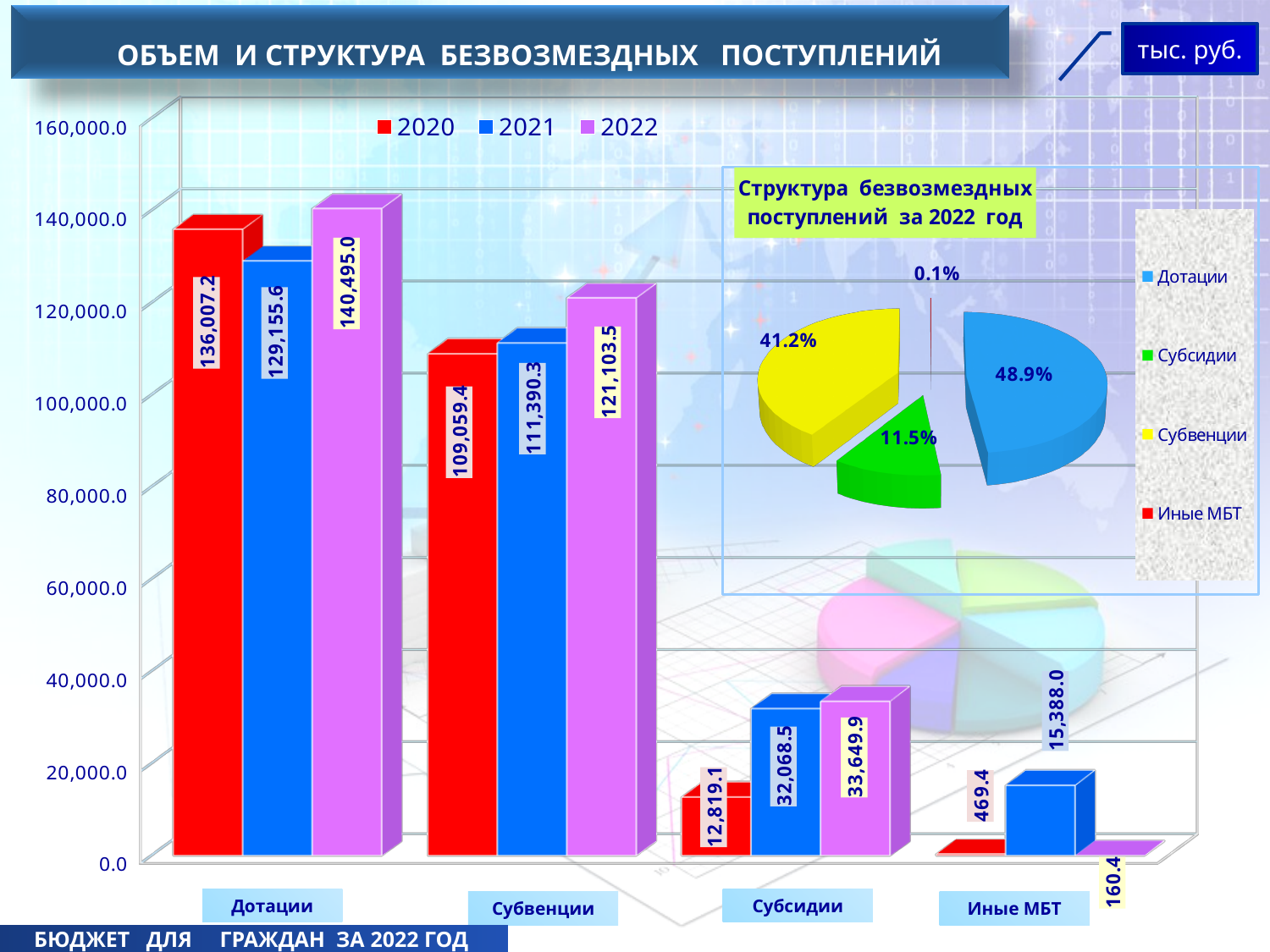
In the bar chart, which category has the highest value for 2022? Дотации In the bar chart, what is the value for Дотации in 2022? 140,495.0 In the pie chart 'Структура безвозмездных поступлений за 2022 год', which slice is the largest? Дотации In the bar chart, what is the value for Иные МБТ in 2020? 469.4 How many series does the legend of the bar chart list? 3 In the bar chart, do the values for Субвенции rise or fall from 2020 to 2022? rise In the pie chart 'Структура безвозмездных поступлений за 2022 год', what share does Субвенции have? 41.2% In the bar chart, what is the value for Субвенции in 2021? 111,390.3 In the bar chart, what is the difference between the 2022 and 2021 values for Субсидии? 1,581.4 How many categories are shown on the x axis of the bar chart? 4 In the bar chart, which is larger for Дотации: the 2020 value or the 2021 value? 2020 In the bar chart, which category has the lowest value for 2021? Иные МБТ